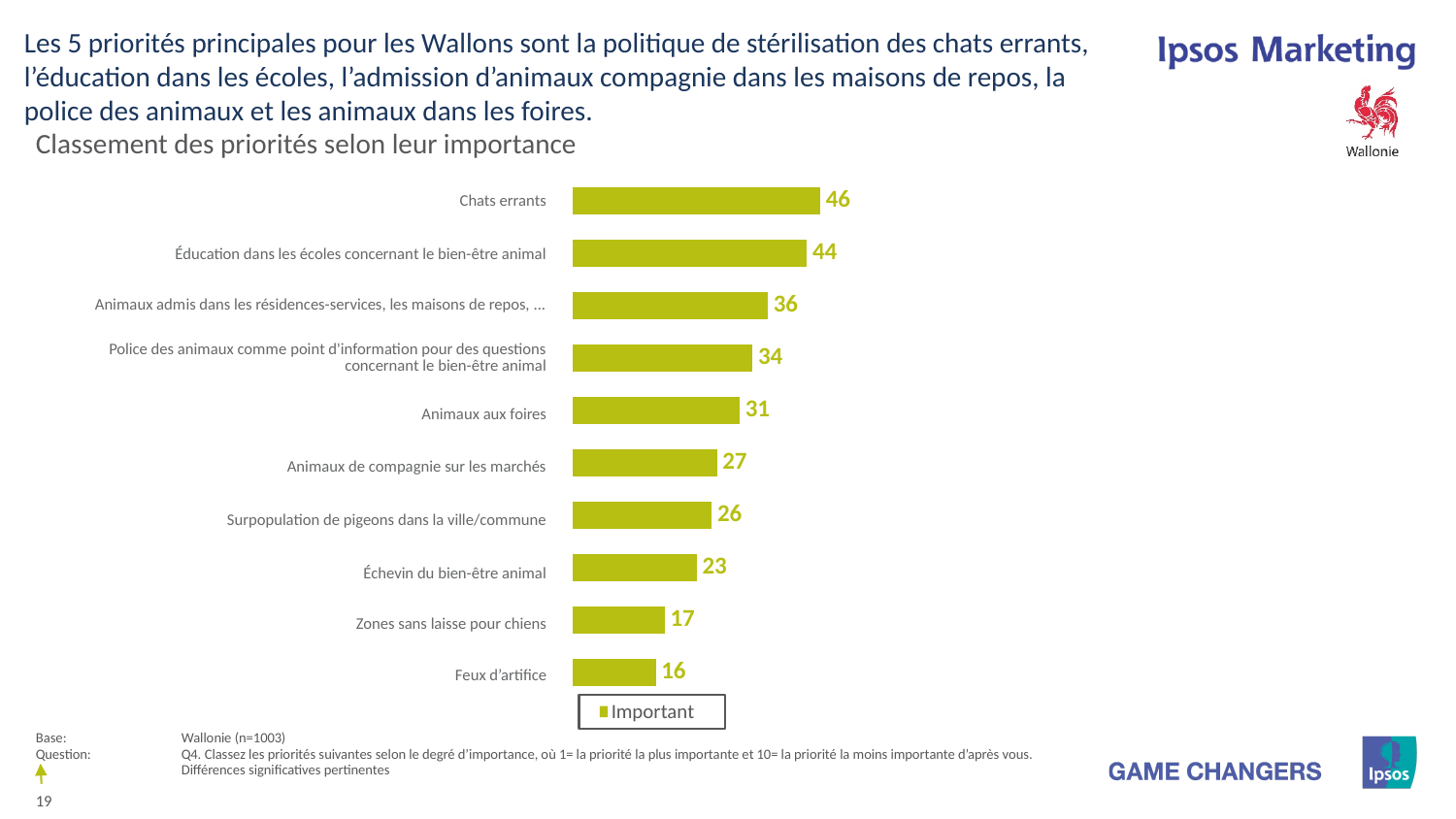
What series name does the legend show? Important What is the difference between the values for Chats errants and Éducation dans les écoles concernant le bien-être animal? 2 What is the value for Surpopulation de pigeons dans la ville/commune? 26 Which category has the highest value? Chats errants What is the difference between the values for Animaux aux foires and Zones sans laisse pour chiens? 14 How many categories are shown in the chart? 10 Which category has the lowest value? Feux d'artifice What is the value for Animaux aux foires? 31 What is the value for Feux d'artifice? 16 Which is larger: the value for Échevin du bien-être animal or the value for Animaux de compagnie sur les marchés? Animaux de compagnie sur les marchés What kind of chart is shown on the slide? Bar chart What is the value for Chats errants? 46